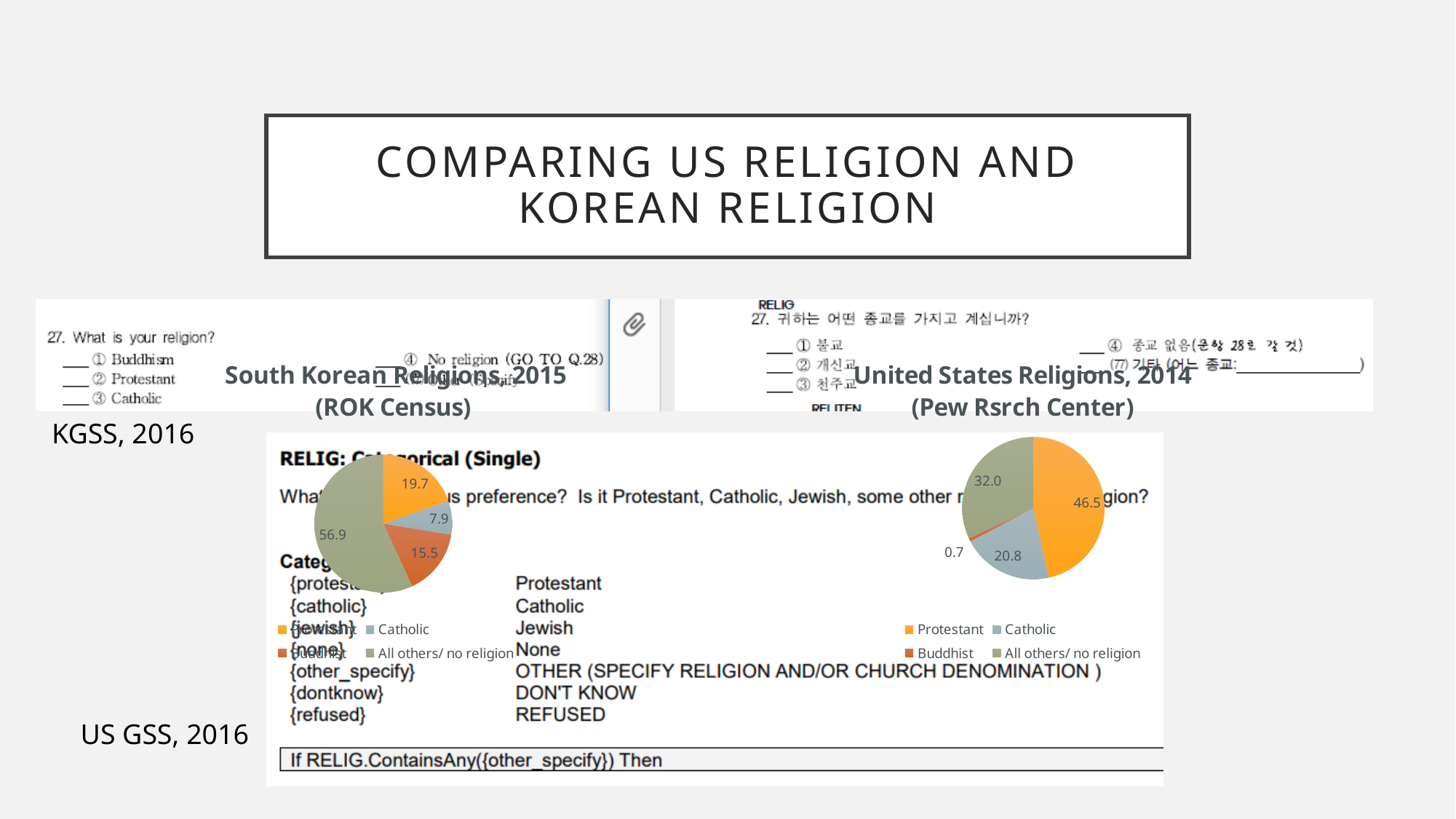
In the South Korean Religions, 2015 chart, which category has the largest slice? All others/ no religion In the United States Religions, 2014 chart, what is the value for Catholic? 20.8 How many categories does the legend of the South Korean Religions, 2015 chart list? 4 In the United States Religions, 2014 chart, which category has the smallest slice? Buddhist In the United States Religions, 2014 chart, what is the value for Buddhist? 0.7 Which is larger: the Catholic value in the South Korean Religions, 2015 chart or the Catholic value in the United States Religions, 2014 chart? United States Religions, 2014 In the South Korean Religions, 2015 chart, what is the value for Protestant? 19.7 What type of chart is the United States Religions, 2014 chart? Pie chart In the United States Religions, 2014 chart, what is the difference between the Protestant and All others/ no religion values? 14.5 In the United States Religions, 2014 chart, which category has the largest slice? Protestant In the South Korean Religions, 2015 chart, what is the difference between the Protestant and Catholic values? 11.8 In the South Korean Religions, 2015 chart, what is the value for Buddhist? 15.5